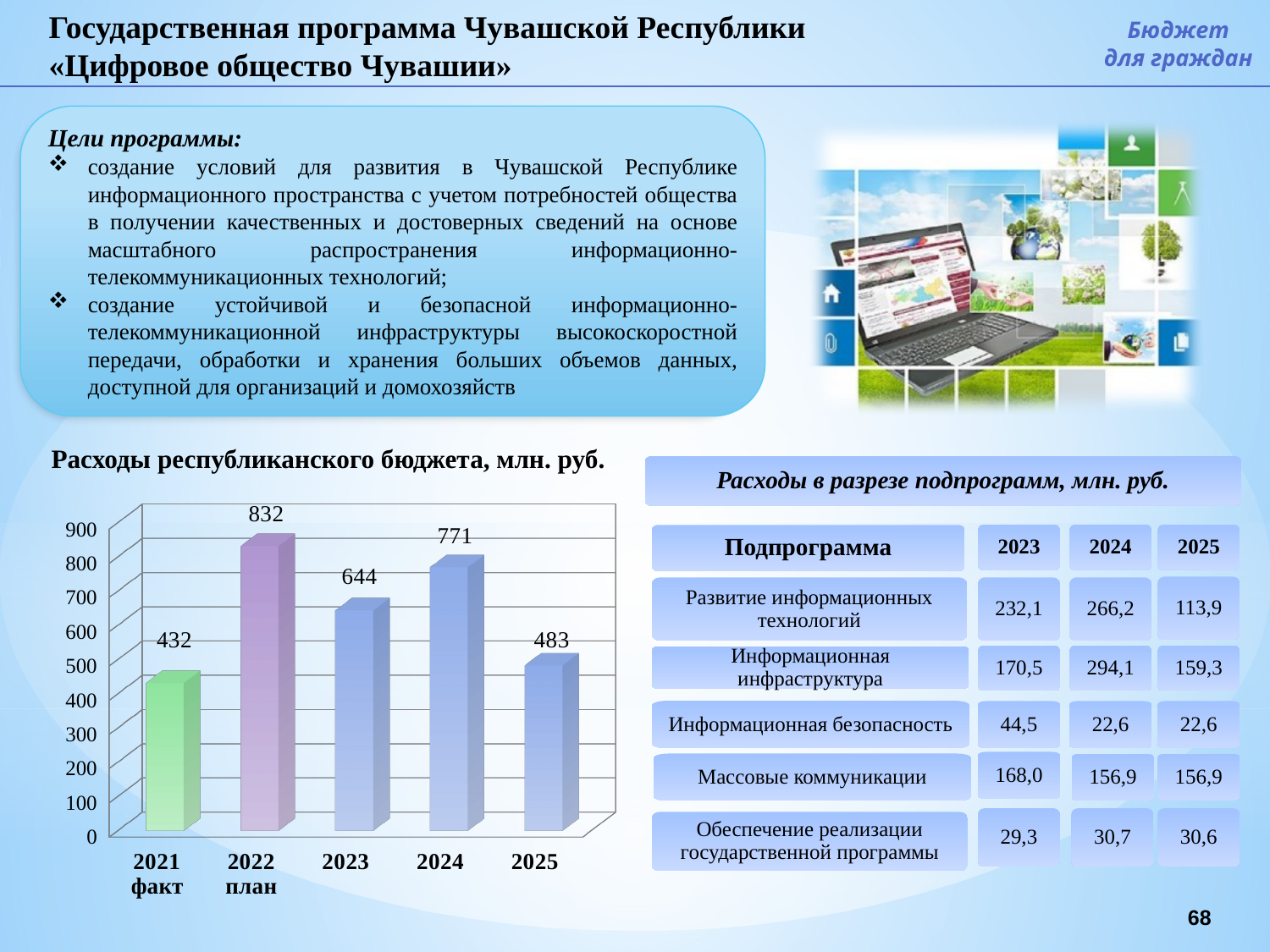
What is the value for 2022 план in the chart 'Расходы республиканского бюджета, млн. руб.'? 832 Which year has the highest value in the chart? 2022 план How many bars are shown in the chart? 5 What is the value for 2025 in the chart? 483 Which year has the lowest value in the chart? 2021 факт What is the value for 2024 in the chart? 771 Which is larger, the value for 2023 or the value for 2025? 2023 What kind of chart is shown on the slide? bar chart What is the difference between the values for 2024 and 2023? 127 What is the difference between the values for 2022 план and 2021 факт? 400 What is the value for 2021 факт in the chart? 432 What is the title of the chart on the slide? Расходы республиканского бюджета, млн. руб.